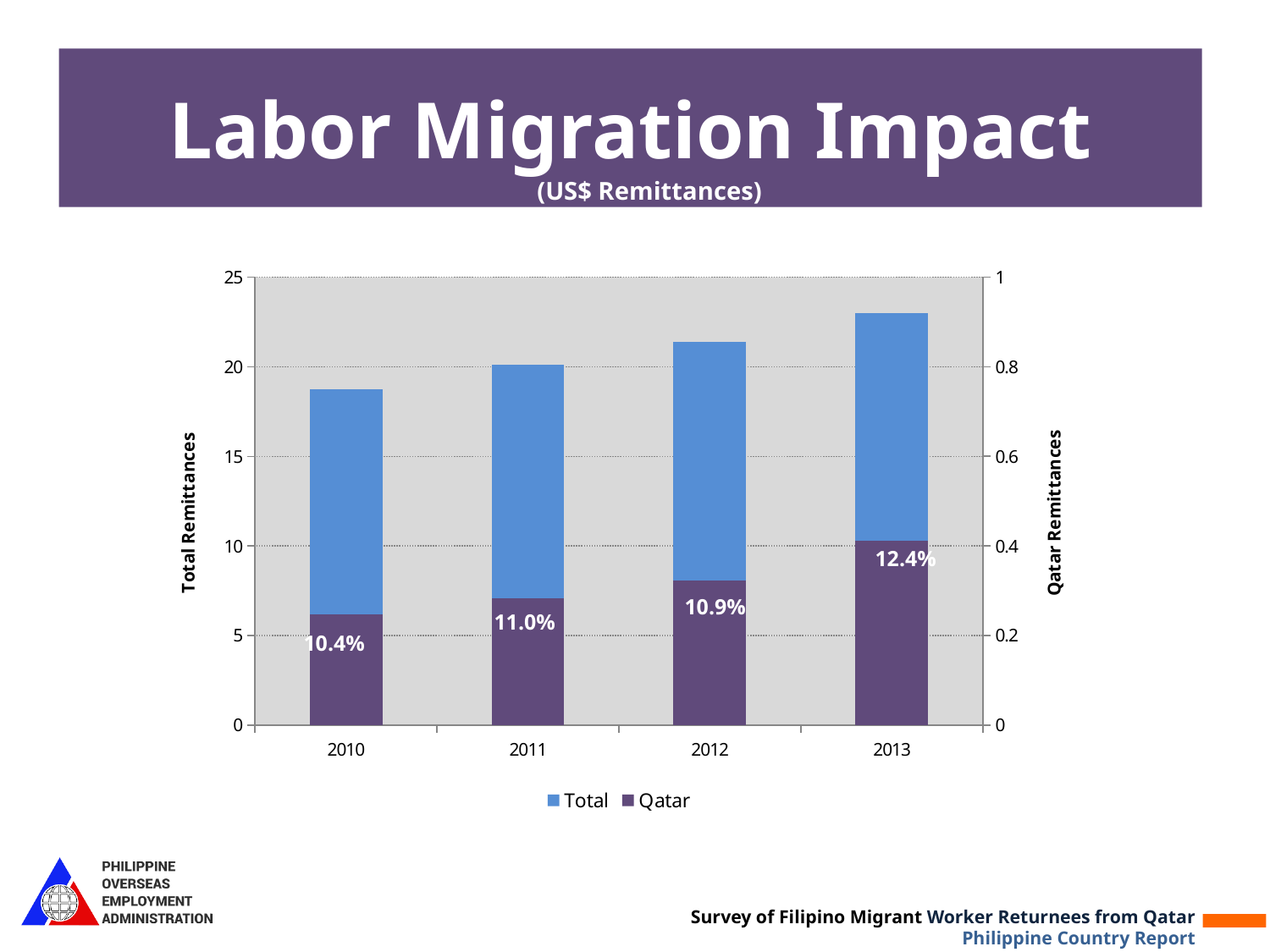
What is the data label shown on the Qatar bar for 2013? 12.4% What is the data label shown on the Qatar bar for 2010? 10.4% Is the Total bar for 2013 greater or less than 20 on the left axis? greater What kind of chart is shown on the slide? Bar chart How many series does the legend list? 2 How many years are shown on the x axis? 4 Which year has the lowest percentage label on its Qatar bar? 2010 What is the difference between the percentage labels for 2013 and 2010? 2.0% Do the Total bars rise or fall from 2010 to 2013? Rise Which year has the larger percentage label, 2011 or 2012? 2011 Is the Total bar for 2010 greater or less than 20 on the left axis? less Which year has the highest percentage label on its Qatar bar? 2013